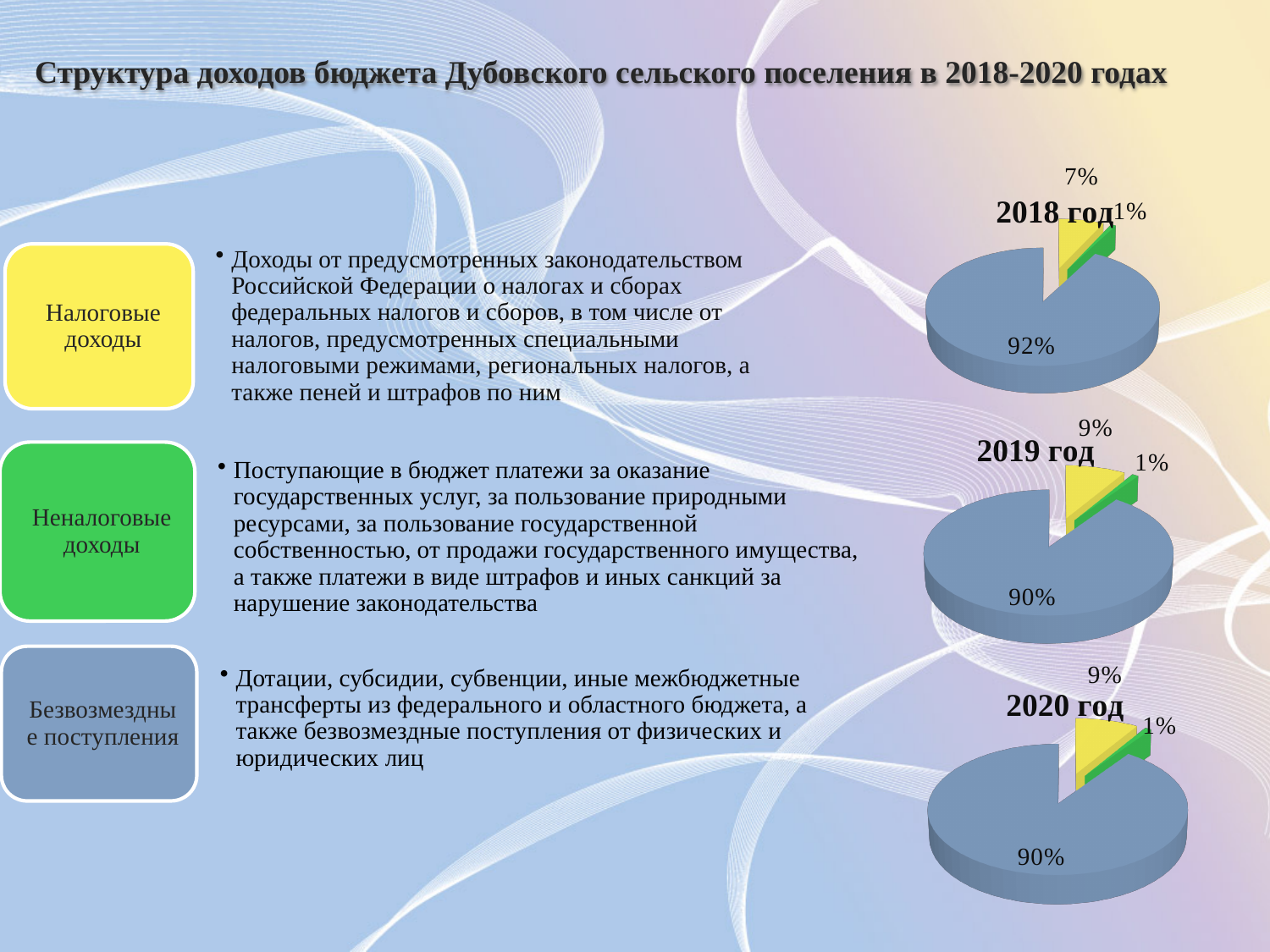
In the "2020 год" pie chart, what is the share of the green slice? 1% In the "2019 год" pie chart, what is the share of the yellow slice? 9% In the "2018 год" pie chart, what is the share of the yellow slice? 7% What is the difference between the largest slice in the "2018 год" chart and the largest slice in the "2019 год" chart? 2% How many pie charts are shown on the slide? 3 In the "2018 год" pie chart, what is the share of the smallest slice? 1% In the "2020 год" pie chart, what is the share of the largest slice? 90% How many slices does the "2020 год" pie chart have? 3 Which is larger: the yellow slice in the "2018 год" chart or the yellow slice in the "2020 год" chart? 2020 год What kind of chart is the "2018 год" chart? pie chart